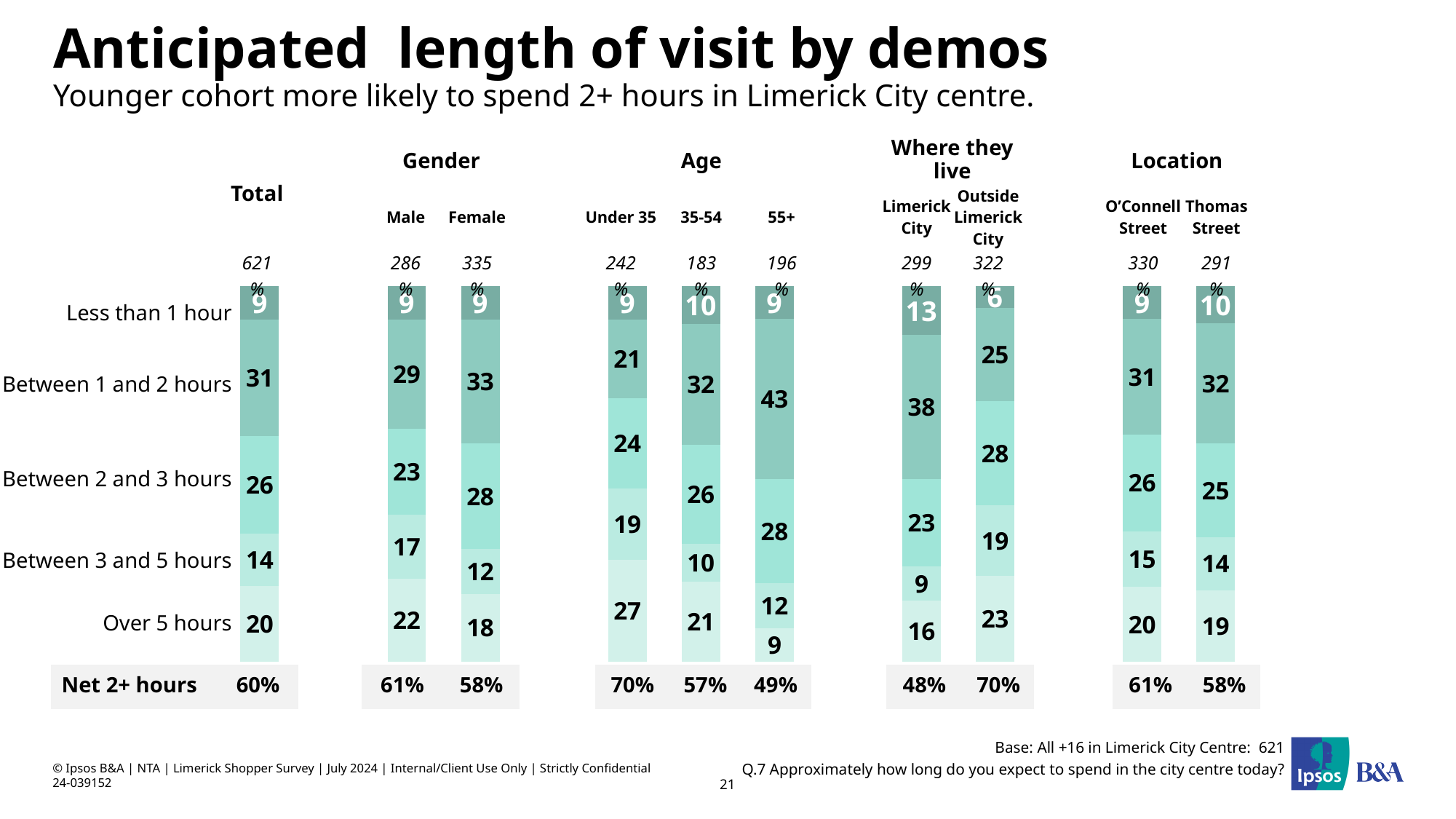
What is the value for 'Between 1 and 2 hours' in the 55+ bar? 43 Which group has the lowest Net 2+ hours figure? Limerick City What is the value for 'Between 1 and 2 hours' in the Total bar? 31 What is the difference between the Limerick City and Outside Limerick City values for 'Between 1 and 2 hours'? 13 What is the difference between the Female and Male values for 'Between 2 and 3 hours'? 5 What is the value for 'Less than 1 hour' in the Limerick City bar? 13 How many bars (demographic groups) are shown in the chart? 10 What is the Net 2+ hours figure for the 35-54 group? 57% What is the value for 'Over 5 hours' in the Under 35 bar? 27 Which is larger for 'Over 5 hours': Under 35 or 55+? Under 35 What kind of chart is shown on the slide? Stacked bar chart Which group has the highest value for 'Over 5 hours'? Under 35